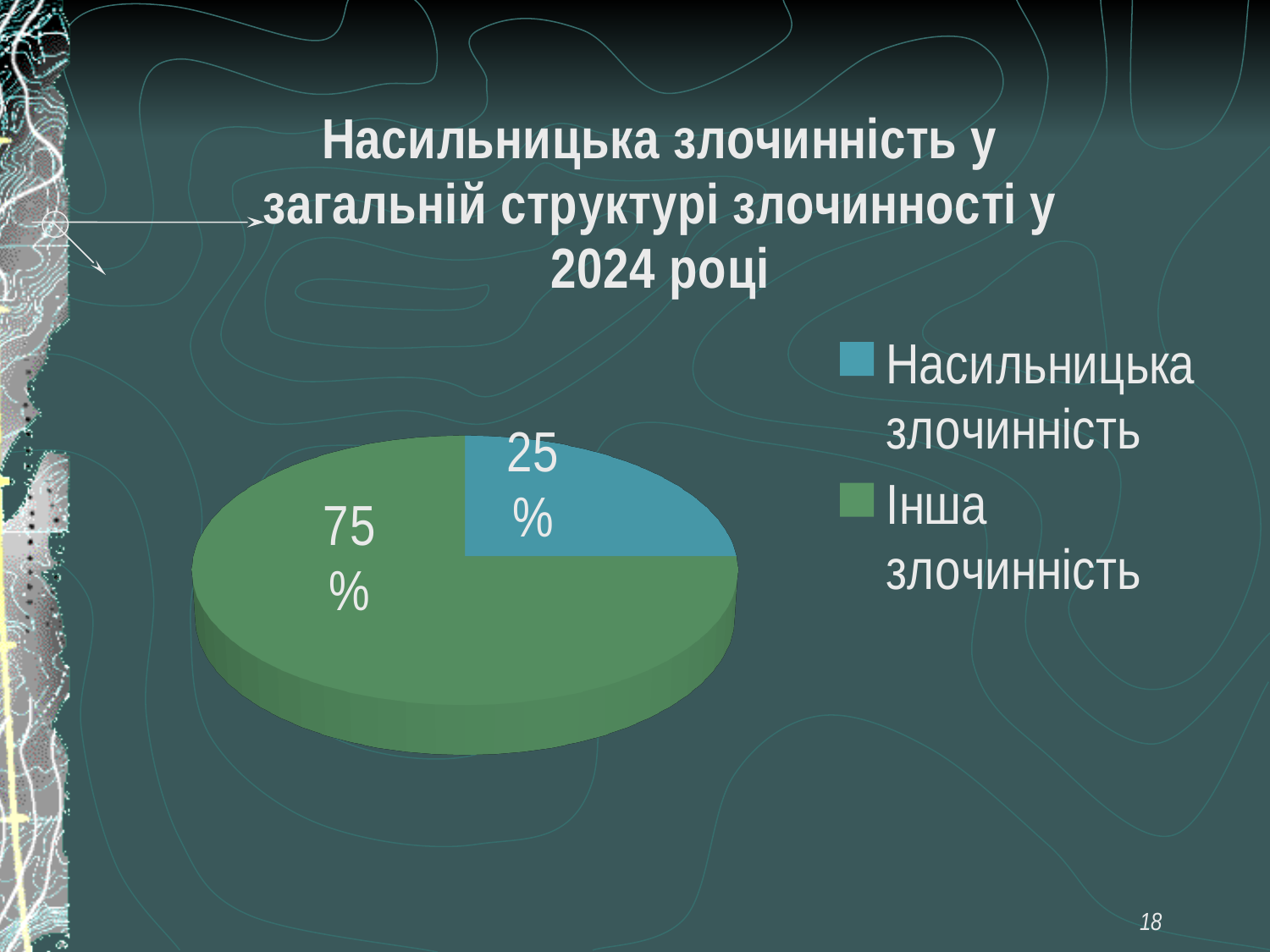
Which is larger: the "Насильницька злочинність" slice or the "Інша злочинність" slice? Інша злочинність What share of the pie is labelled "Насильницька злочинність"? 25% How many slices does the pie chart have? 2 What is the total of the two slice percentages shown on the pie? 100% Which slice of the pie is the largest? Інша злочинність What colour is the "Насильницька злочинність" slice? blue What is the difference in percentage points between the "Інша злочинність" slice and the "Насильницька злочинність" slice? 50 What kind of chart is shown on the slide? pie chart Which slice of the pie is the smallest? Насильницька злочинність What share of the pie is labelled "Інша злочинність"? 75% How many entries does the legend list? 2 What colour is the "Інша злочинність" slice? green